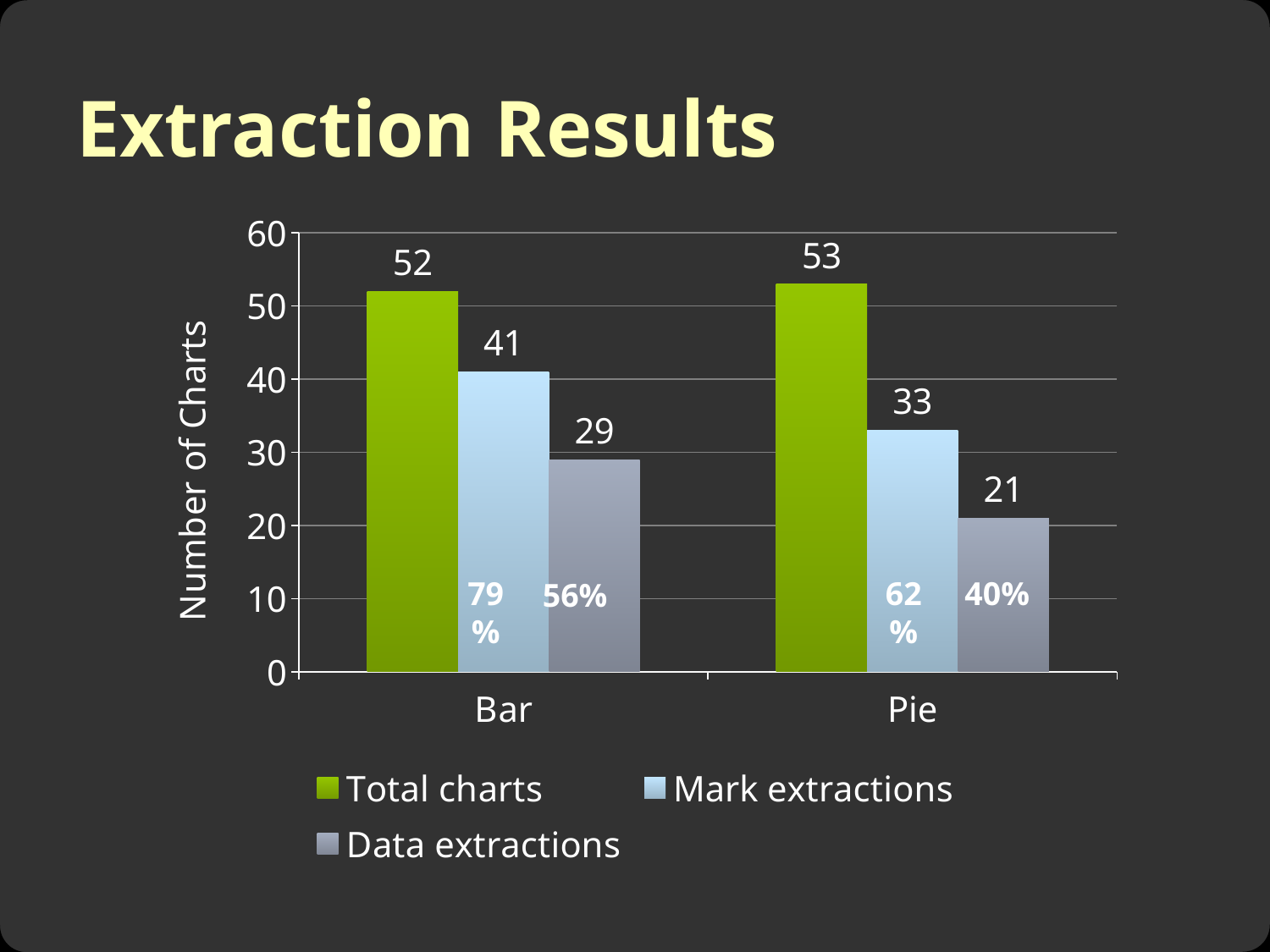
Which series has the lowest value in the Pie category? Data extractions How many series does the legend list? 3 What is the title of the y axis? Number of Charts Which category has the higher value for Mark extractions? Bar Is the value of Total charts for Bar or for Pie larger? Pie What is the difference between Total charts and Mark extractions for the Bar category? 11 What is the value of Mark extractions for the Pie category? 33 What is the value of Data extractions for the Bar category? 29 How many categories are shown on the x axis? 2 What is the value of Data extractions for the Pie category? 21 What kind of chart is shown on the slide? Bar chart What is the value of Total charts for the Bar category? 52